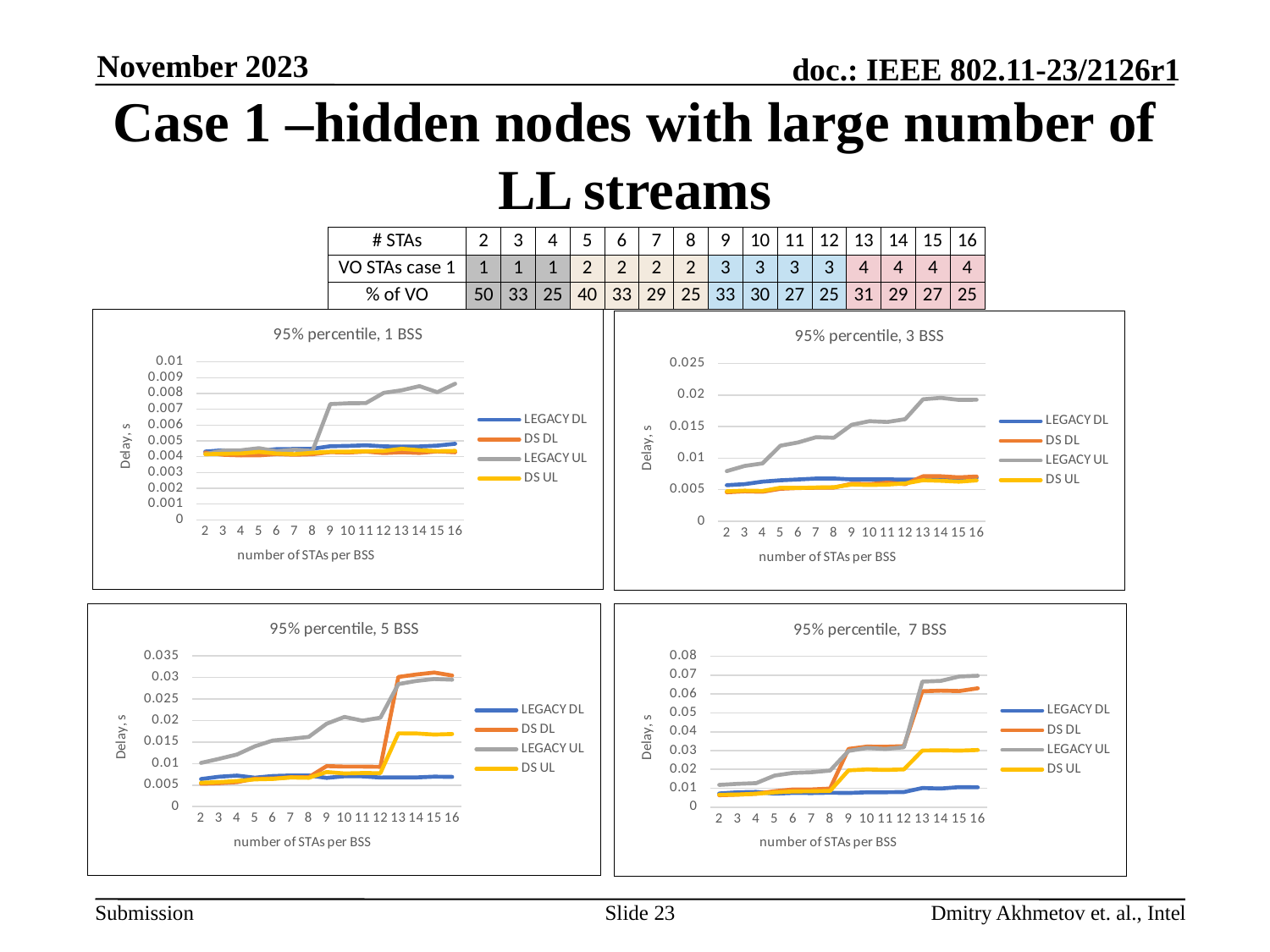
In '95% percentile, 5 BSS', is the LEGACY DL value at 16 STAs greater or less than 0.01? less In '95% percentile, 1 BSS', is the LEGACY UL value at 16 STAs greater or less than 0.007? greater What kind of chart is '95% percentile, 1 BSS'? line chart In '95% percentile, 1 BSS', which series has the highest value at 16 STAs per BSS? LEGACY UL How many series does the legend of '95% percentile, 3 BSS' list? 4 In '95% percentile, 7 BSS', which series has the lowest value at 16 STAs per BSS? LEGACY DL In '95% percentile, 3 BSS', is the LEGACY UL value at 16 STAs greater or less than 0.015? greater How many x-axis points (number of STAs per BSS) are plotted in '95% percentile, 5 BSS'? 15 In '95% percentile, 5 BSS', which is larger at 10 STAs per BSS: LEGACY UL or DS DL? LEGACY UL What is the y-axis label of the '95% percentile, 7 BSS' chart? Delay, s In '95% percentile, 3 BSS', does the LEGACY UL series generally rise or fall as the number of STAs per BSS increases? rise